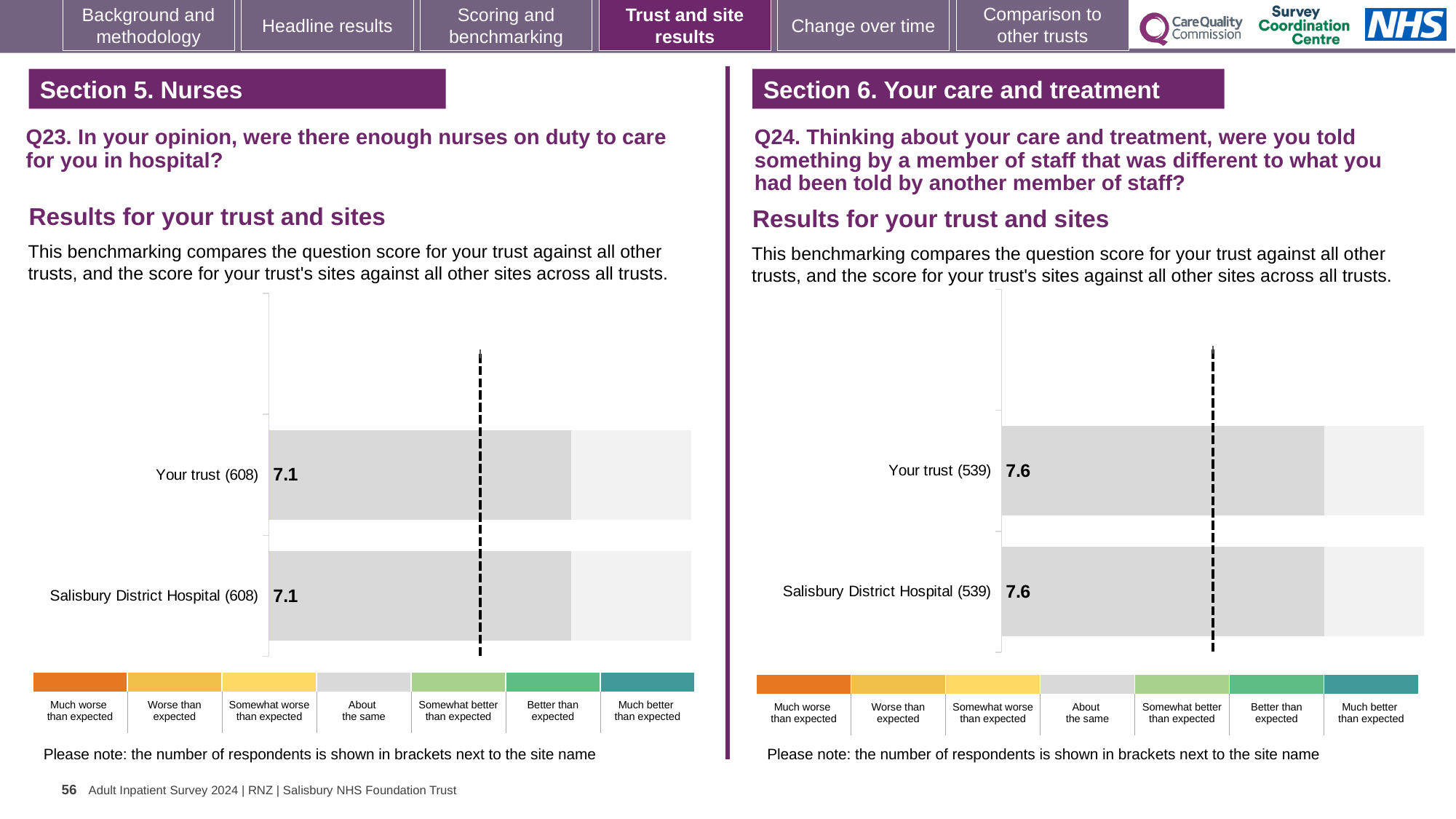
On the Q23 chart (left), what is the difference between the score for Your trust and the score for Salisbury District Hospital? 0 How many bars are plotted on the Q24 chart (right)? 2 On the Q24 chart (right), what is the score for Your trust? 7.6 How many bars are plotted on the Q23 chart (left)? 2 On the Q24 chart (right), what is the score for Salisbury District Hospital? 7.6 What kind of chart is used for the Q23 results on the left? Bar chart Is the Your trust score on the Q24 chart (right) larger or smaller than the Your trust score on the Q23 chart (left)? Larger On the Q23 chart (left), what is the score for Salisbury District Hospital? 7.1 On the Q23 chart (left), how many respondents are shown in brackets next to Your trust? 608 On the Q23 chart (left), what is the score for Your trust? 7.1 On the Q24 chart (right), what is the difference between the score for Your trust and the score for Salisbury District Hospital? 0 On the Q24 chart (right), how many respondents are shown in brackets next to Salisbury District Hospital? 539